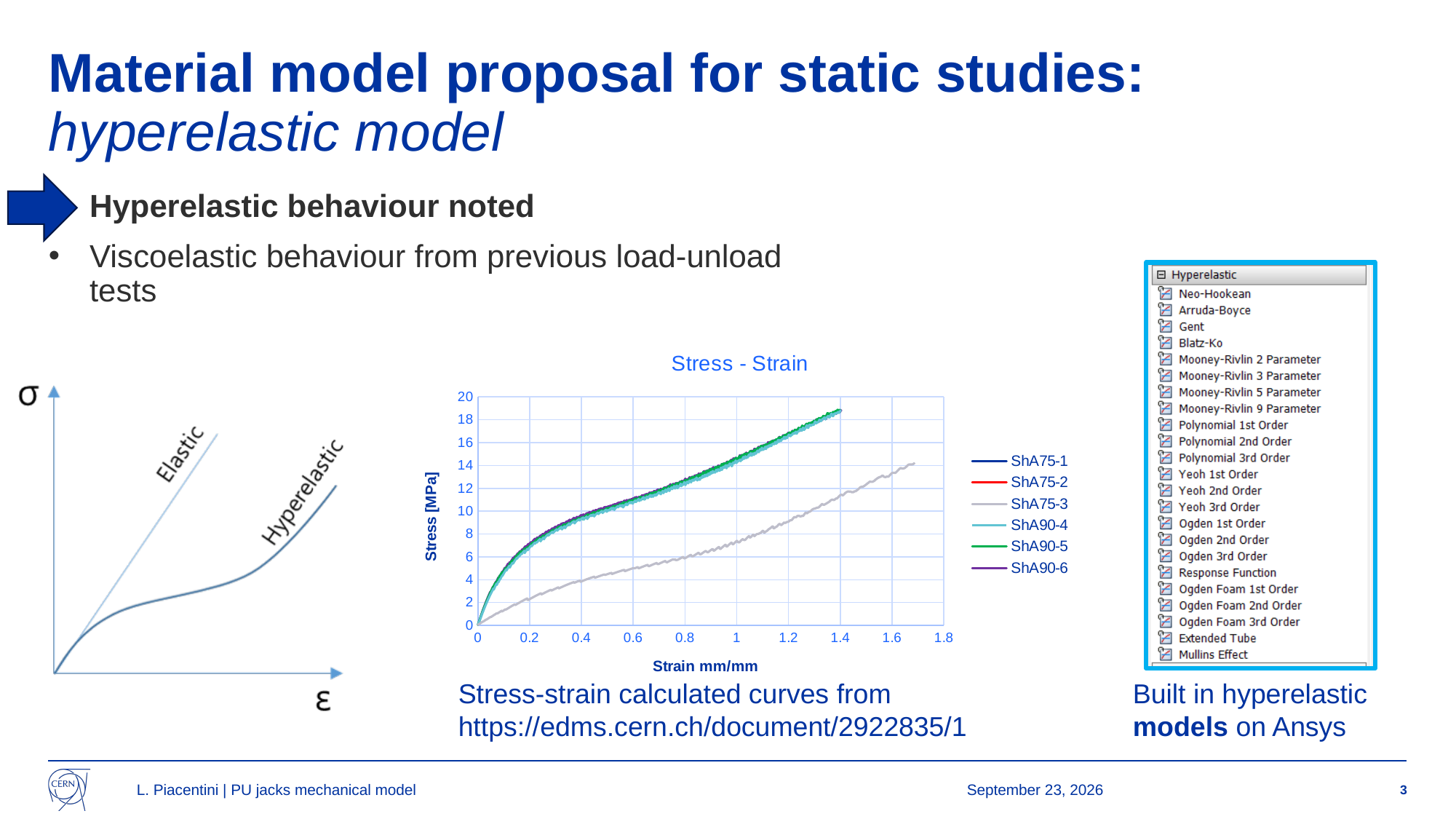
What is the title of the chart in the middle of the slide? Stress - Strain In the "Stress - Strain" chart, is the maximum stress reached by ShA75-3 greater or less than 16? less In the "Stress - Strain" chart, is the stress of ShA75-3 at a strain of 1 greater or less than 10? less What is the highest tick value shown on the vertical axis of the "Stress - Strain" chart? 20 What is the label of the vertical axis of the "Stress - Strain" chart? Stress [MPa] In the "Stress - Strain" chart, is the stress of ShA90-5 at a strain of 1 greater or less than 10? greater In the "Stress - Strain" chart, do the stress values rise or fall as strain increases? rise In the "Stress - Strain" chart, which series lies clearly below all the others? ShA75-3 What kind of chart is the "Stress - Strain" chart? line chart In the "Stress - Strain" chart, which series has the higher stress at a strain of 1: ShA75-3 or ShA90-5? ShA90-5 How many series does the legend of the "Stress - Strain" chart list? 6